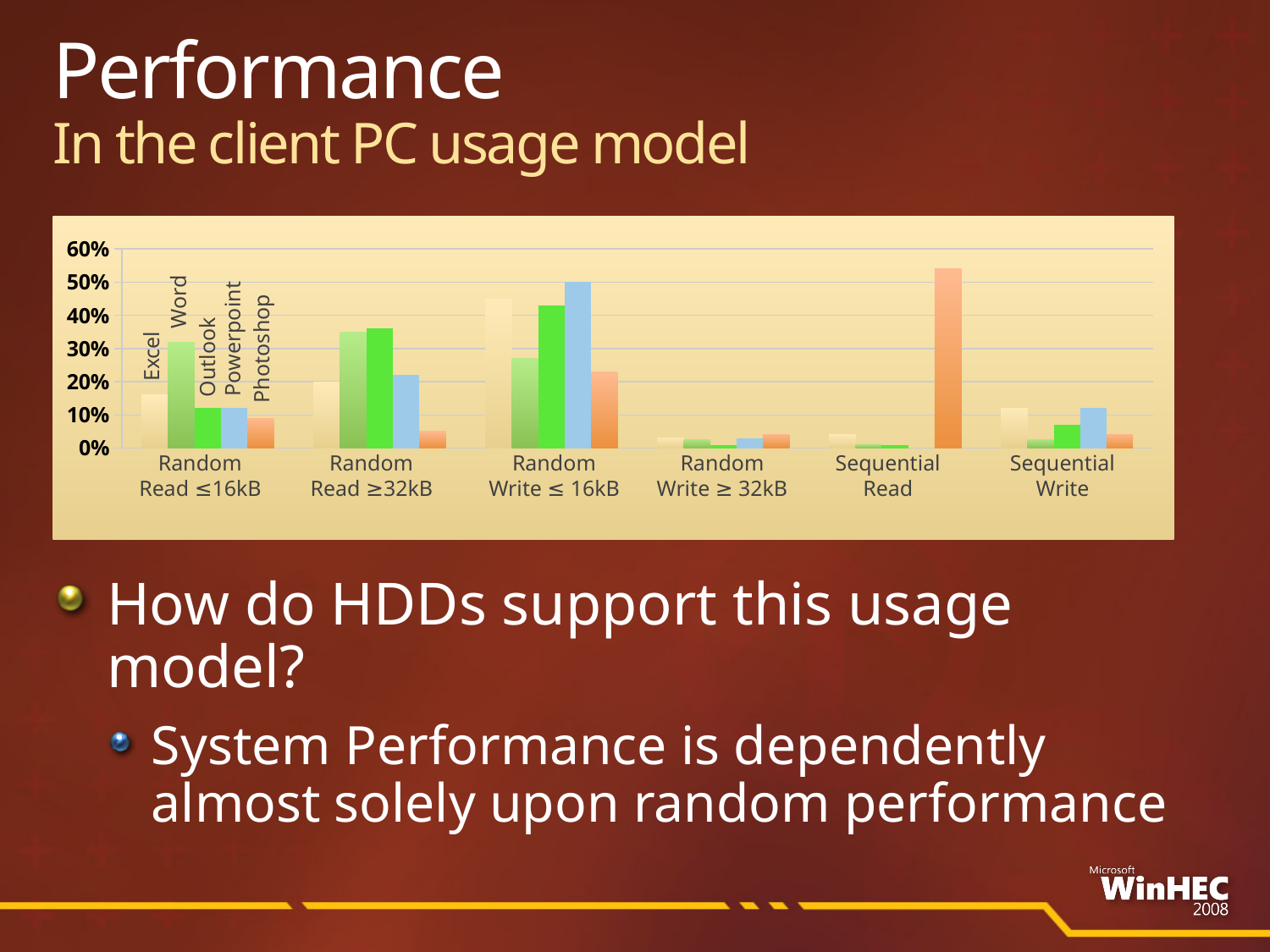
In which category does Photoshop have its highest value? Sequential Read What is the highest value shown on the chart's y axis? 60% Is the value for Photoshop in Sequential Read greater or less than 50%? greater Is the value for Word in Random Read ≤16kB greater or less than 30%? greater Which is larger: the Word value for Random Read ≤16kB or the Outlook value for Random Read ≤16kB? Word What kind of chart is shown on the slide? bar chart How many categories are shown along the x axis of the chart? 6 Which application series has the tallest bar in the Sequential Read category? Photoshop Which is larger: the Photoshop value for Sequential Read or the Photoshop value for Random Read ≤16kB? Sequential Read How many application series are labeled in the chart? 5 Is the value for Excel in Random Read ≤16kB greater or less than 20%? less